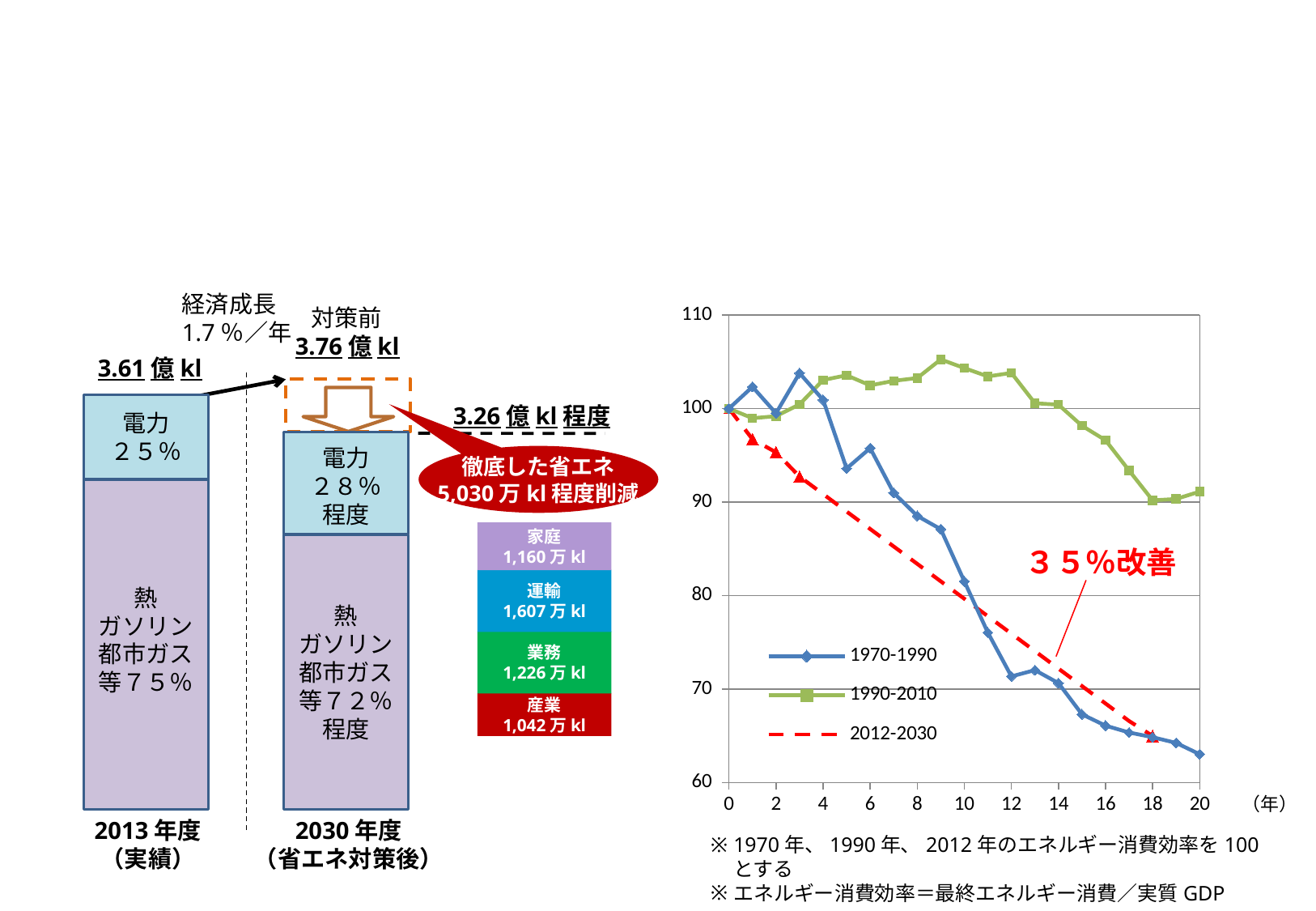
How many series does the legend of the right-hand line chart list? 3 What kind of chart is the chart on the right side of the slide? line chart In the left-hand chart, what is the difference between the 運輸 reduction and the 産業 reduction? 565万kl In the left-hand stacked bar chart, what share of the 2013年度 bar is 電力? ２５％ In the right-hand line chart, which series is higher at year 20, 1970-1990 or 1990-2010? 1990-2010 In the right-hand line chart, does the 1970-1990 series rise or fall as the years increase from 0 to 20? fall In the left-hand chart, which sector in the savings breakdown has the largest reduction? 運輸 In the left-hand stacked bar chart, what share of the 2030年度 bar is 熱・ガソリン・都市ガス等? ７２％程度 In the right-hand line chart, is the value of the 1990-2010 series at year 9 greater or less than 100? greater In the right-hand line chart, is the value of the 1970-1990 series at year 20 greater or less than 70? less In the right-hand line chart, what improvement percentage is annotated in red next to the dashed 2012-2030 line? ３５％改善 In the left-hand stacked bar chart, what total is printed above the 2013年度 bar? 3.61億kl